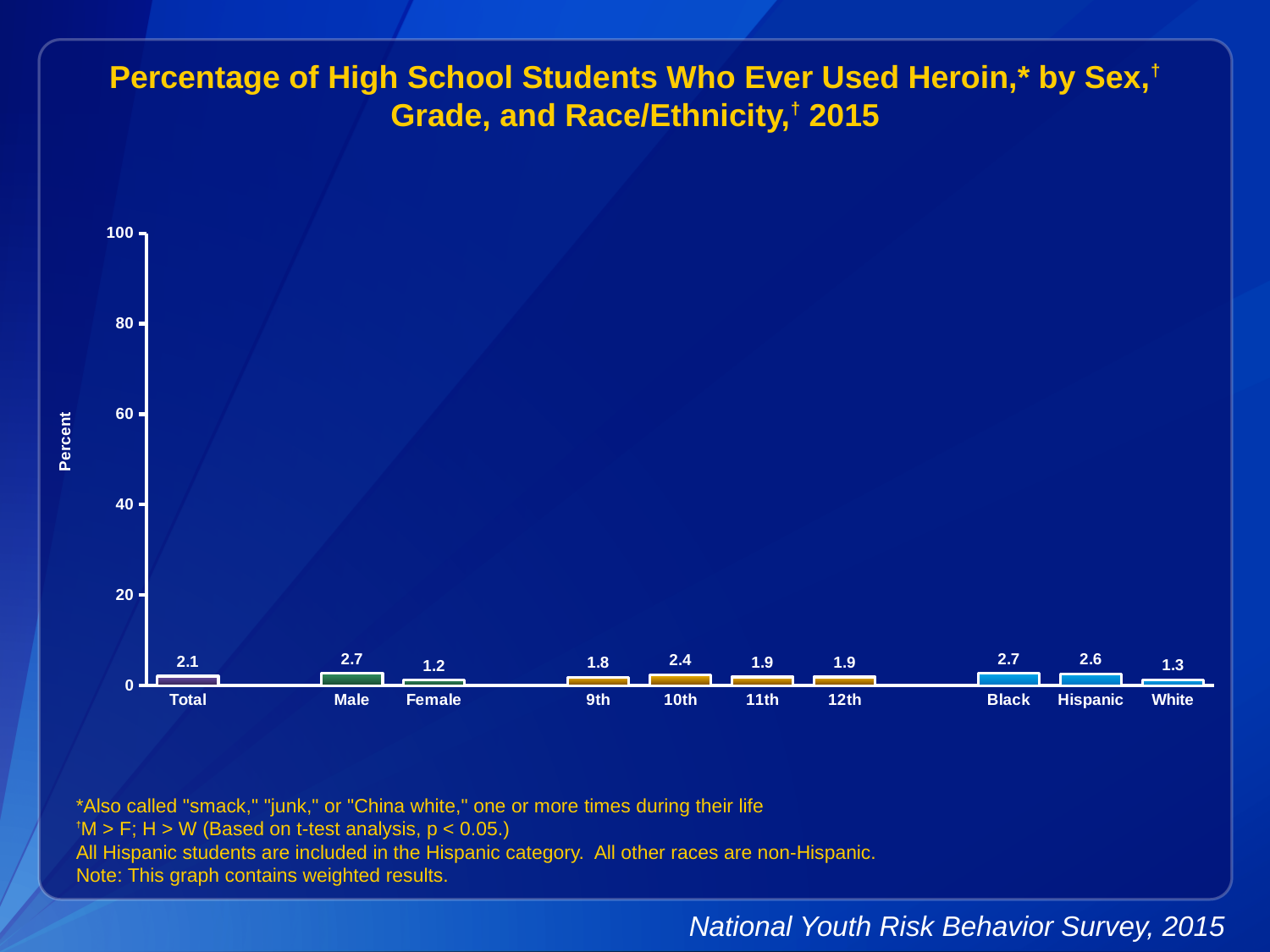
Among the grade categories (9th, 10th, 11th, 12th), which has the highest value? 10th What percentage of female high school students ever used heroin? 1.2 Which is larger, the value for 9th grade or the value for 10th grade? 10th grade What is the value shown for Hispanic students? 2.6 What is the difference between the values for Male and Female students? 1.5 How many categories are plotted on the chart? 10 Among the race/ethnicity categories, which has the lowest value? White What is the value shown for the Total bar? 2.1 What is the difference between the values for Black and White students? 1.4 What is the value shown for 10th grade students? 2.4 Which category has the lowest value on the chart? Female What type of chart is shown on the slide? Bar chart